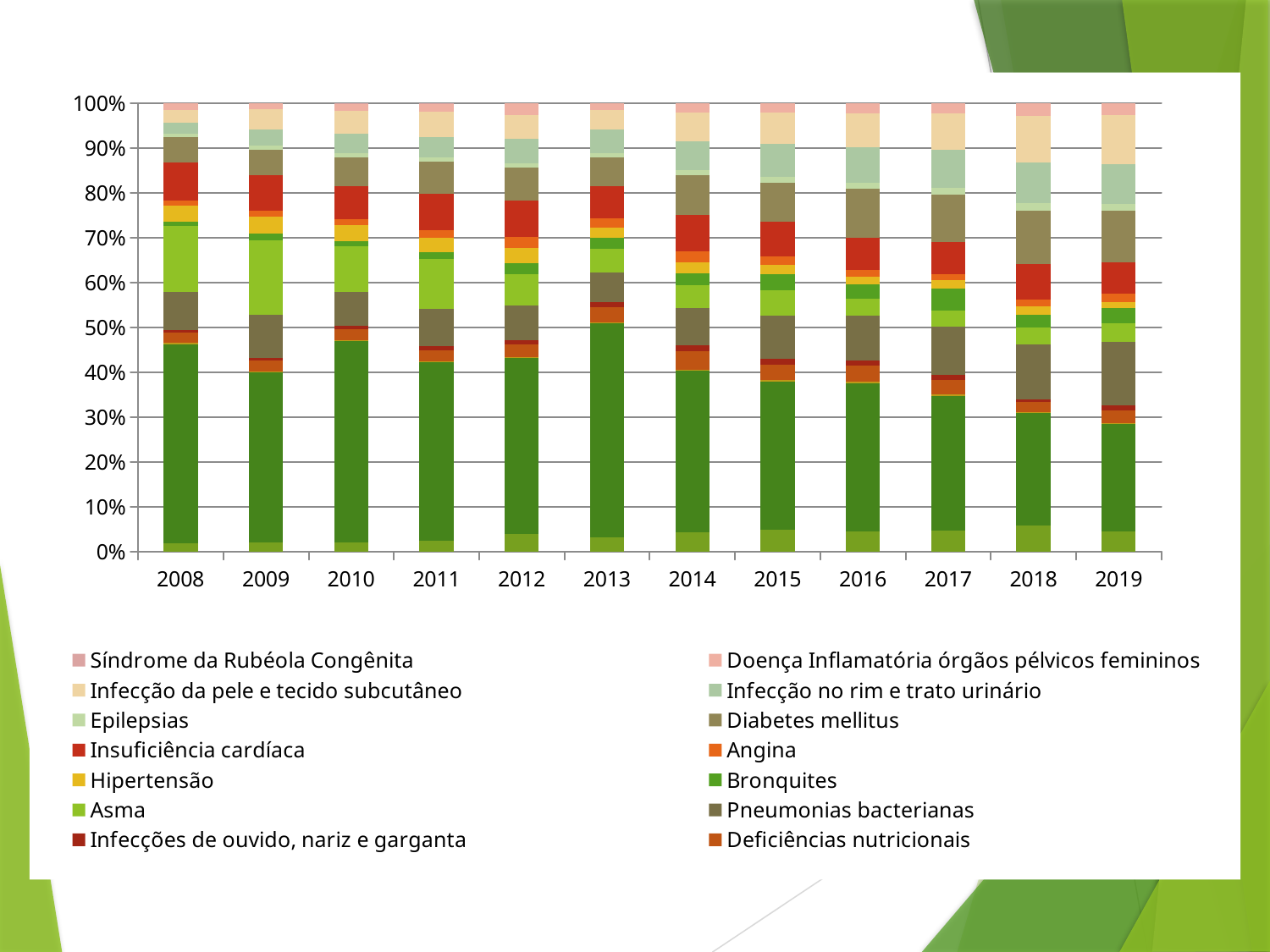
Which year has the smallest share for the large dark green segment at the bottom of the bars? 2019 How many years are shown on the x axis of the chart? 12 What is the total of the stacked bar for 2015? 100% What is the highest value shown on the y axis? 100% What kind of chart is shown on the slide? Stacked bar chart Which year has the largest share for the large dark green segment at the bottom of the bars? 2013 Is the top of the large dark green segment at the bottom of the 2019 bar greater or less than 40%? less From 2013 to 2019, does the share of the large dark green segment at the bottom of the bars rise or fall? fall Is the top of the large dark green segment at the bottom of the 2010 bar greater or less than 40%? greater How many series does the legend list? 14 What is the first year shown on the x axis? 2008 Is the top of the large dark green segment at the bottom of the 2008 bar greater or less than 50%? less